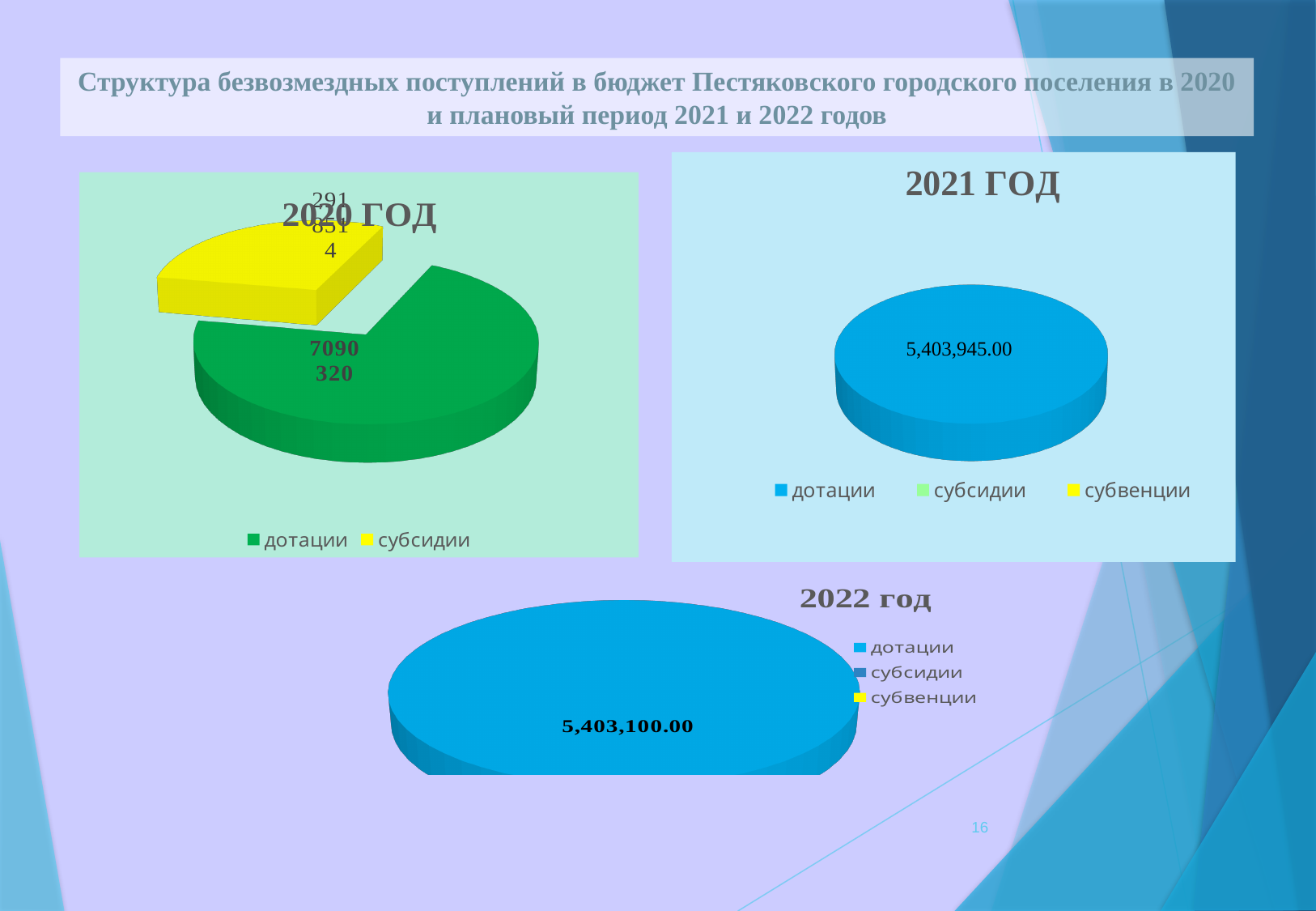
How many entries does the legend of the 2020 ГОД chart list? 2 How many entries does the legend of the 2022 год chart list? 3 What is the title of the chart in the top right of the slide? 2021 ГОД Which is larger, the дотации value in the 2021 ГОД chart or the дотации value in the 2022 год chart? 2021 ГОД What is the difference between the дотации value in the 2021 ГОД chart and the дотации value in the 2022 год chart? 845.00 In the 2022 год chart, what value is shown for дотации? 5,403,100.00 In the 2021 ГОД chart, what value is shown for дотации? 5,403,945.00 How many entries does the legend of the 2021 ГОД chart list? 3 What colour is the дотации slice in the 2020 ГОД chart? green How many slices are visible in the 2020 ГОД pie chart? 2 What kind of chart is the 2020 ГОД chart? pie chart In the 2020 ГОД chart, which slice is larger, дотации or субсидии? дотации